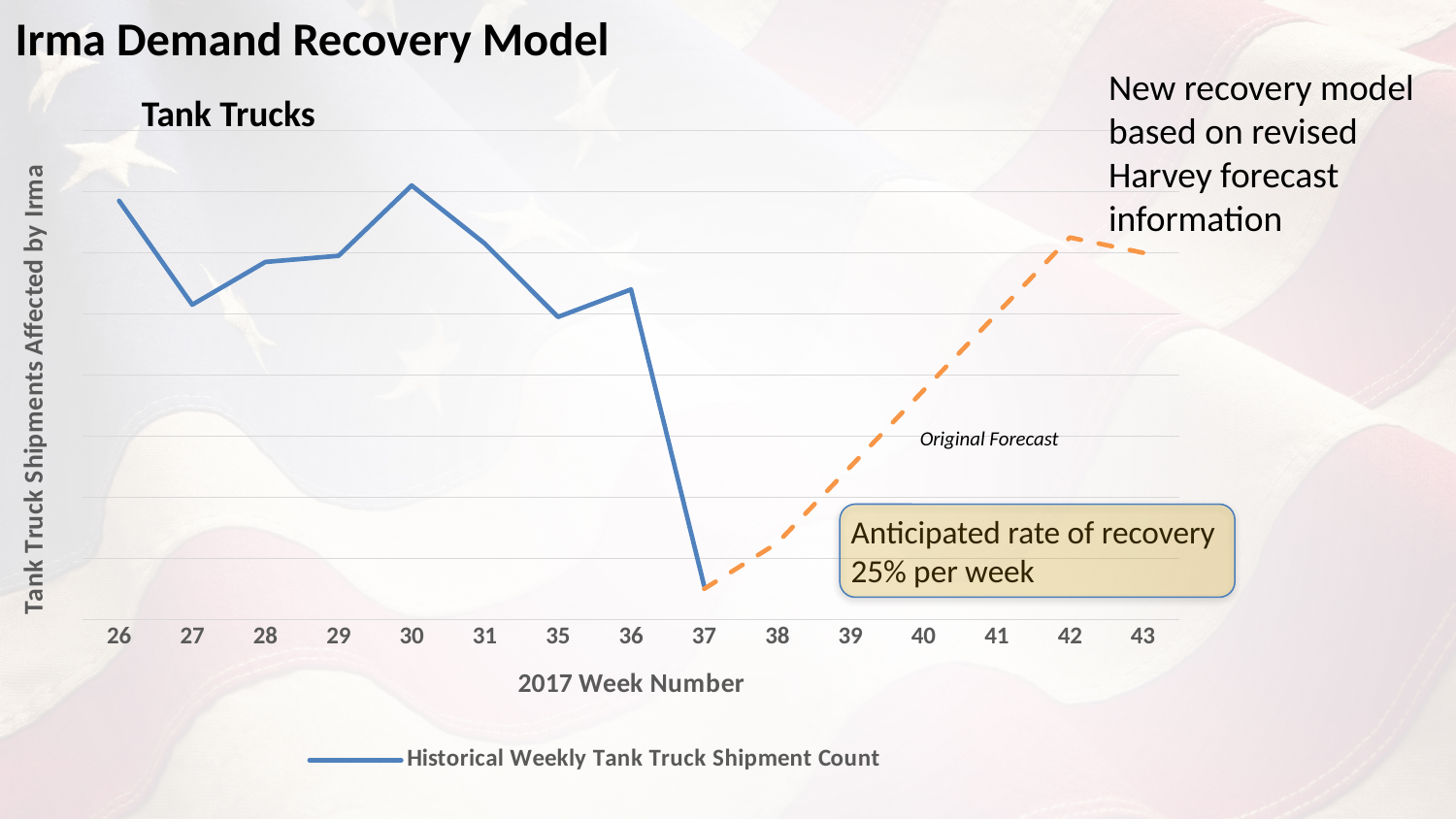
How many series does the chart legend list? 1 What is the title of the chart? Tank Trucks Does the dashed forecast line rise or fall from week 37 to week 42? rise Does the historical line rise or fall from week 27 to week 30? rise What is the name of the series listed in the legend? Historical Weekly Tank Truck Shipment Count What kind of chart is shown on the slide? line chart At which week number does the solid historical line reach its lowest point? 37 Which week has the higher historical value, week 28 or week 35? 28 At which week number does the solid historical line reach its highest point? 30 How many week numbers are shown on the x axis? 15 Which week has the higher historical value, week 26 or week 27? 26 Does the historical line rise or fall from week 36 to week 37? fall